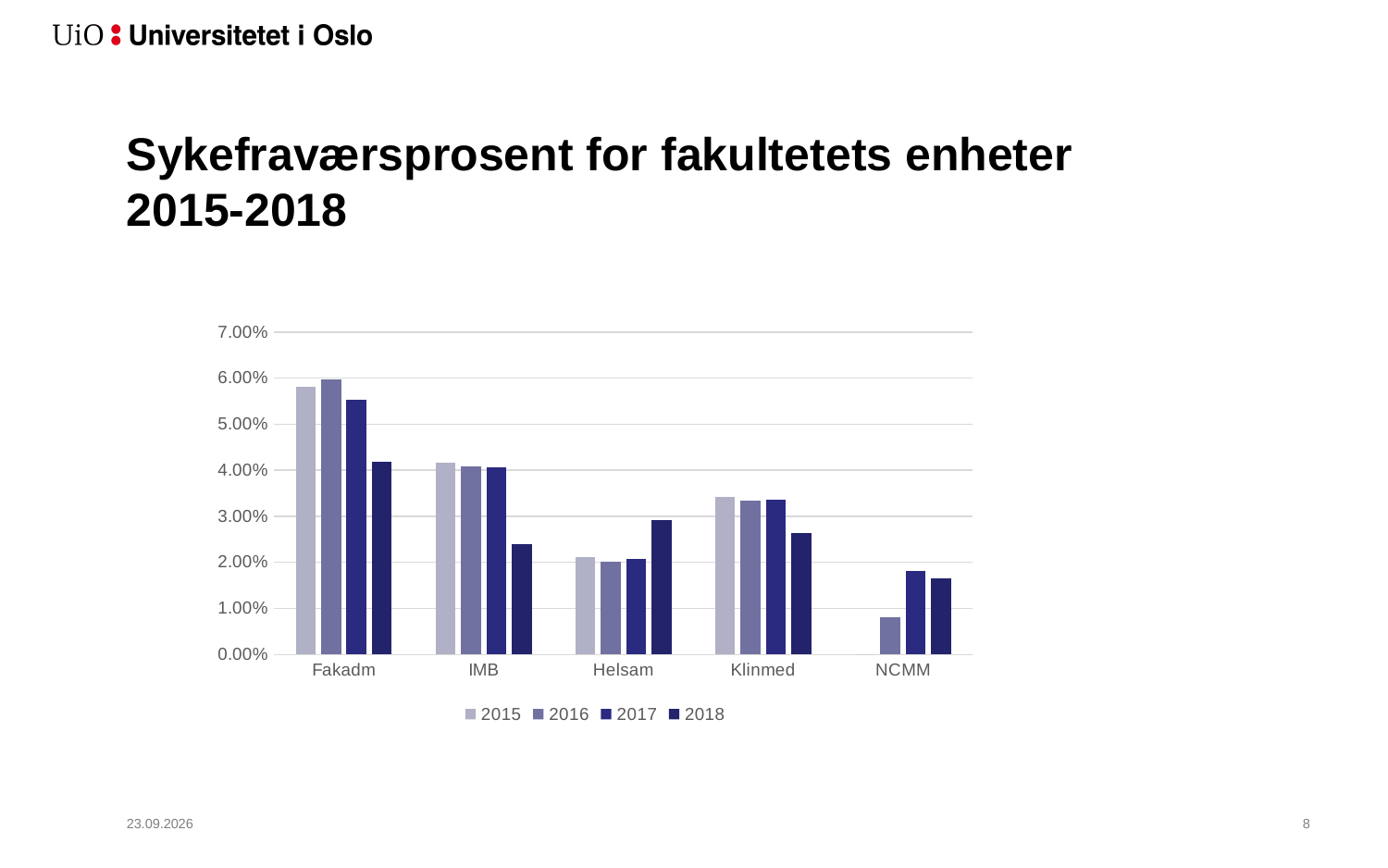
Is the 2018 value for IMB greater or less than 3.00%? less Do the values for IMB rise or fall from 2015 to 2018? fall Which unit has the lowest sick leave percentage for 2018? NCMM Is the 2018 value for Helsam greater or less than 2.00%? greater Is the 2016 value for NCMM greater or less than 1.00%? less What is the title of the chart slide? Sykefraværsprosent for fakultetets enheter 2015-2018 What kind of chart is shown on the slide? bar chart Which unit has the highest sick leave percentage for 2015? Fakadm How many units (categories) are shown on the x axis? 5 Which is larger, the 2018 value for Fakadm or the 2018 value for IMB? Fakadm How many series does the legend list? 4